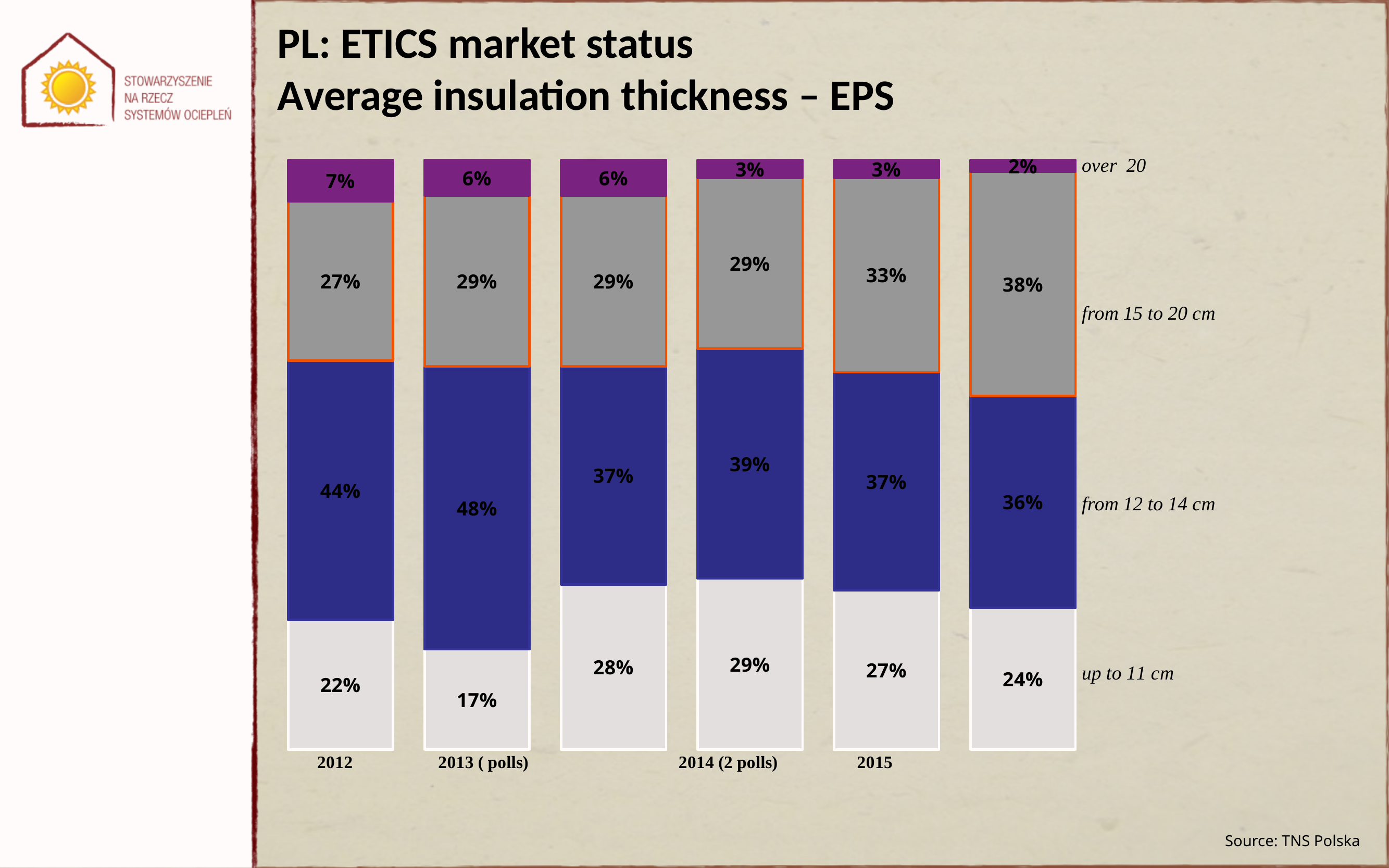
In 2012, how many percentage points larger is 'from 12 to 14 cm' than 'up to 11 cm'? 22 percentage points Which has the larger 'up to 11 cm' share, 2014 (2 polls) or 2015? 2014 (2 polls) Which bar has the lowest 'up to 11 cm' share? 2013 ( polls) Which bar has the highest 'from 12 to 14 cm' share? 2013 ( polls) What share of the 2012 bar is 'from 12 to 14 cm'? 44% What type of chart is shown on the slide? Stacked bar chart How many thickness categories (series) are stacked in each bar? 4 Which bar has the highest 'from 15 to 20 cm' share? The rightmost bar (38%) How many stacked bars are shown in the chart? 6 What is the 'over 20' value in the rightmost bar? 2% What is the 'up to 11 cm' value for 2013 ( polls)? 17% What is the 'from 15 to 20 cm' value for 2015? 33%